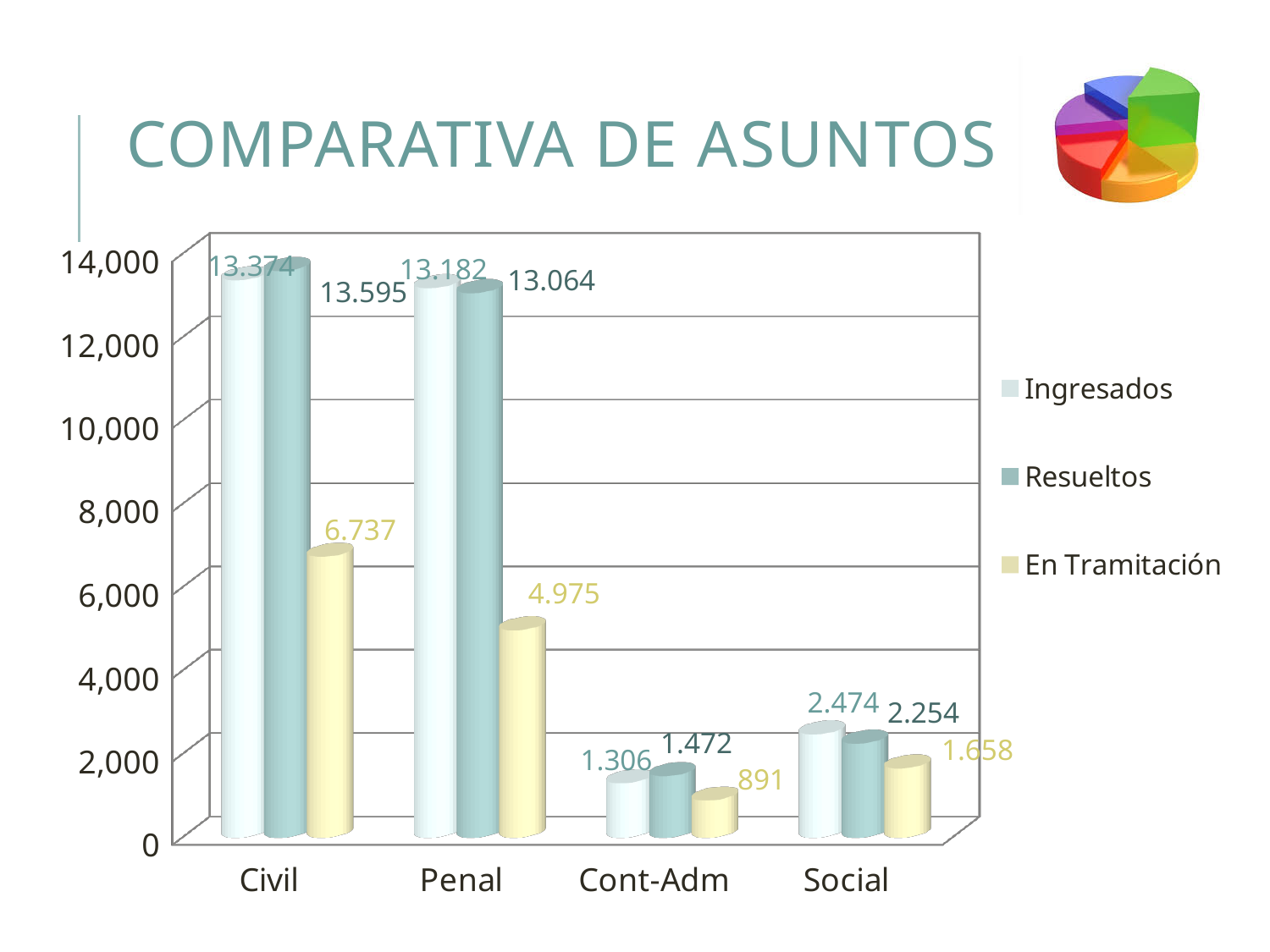
Which category has the lowest En Tramitación value? Cont-Adm Is the En Tramitación value for Penal greater or less than 6,000? less How many series does the legend list? 3 Which is larger for Cont-Adm, Ingresados or Resueltos? Resueltos Which category has the highest Resueltos value? Civil How many categories are shown on the x axis? 4 What kind of chart is shown on the slide? bar chart What is the difference between the Resueltos and Ingresados values for Civil? 221 What is the En Tramitación value for Cont-Adm? 891 What is the En Tramitación value for Social? 1.658 What is the Ingresados value for Civil? 13.374 What is the Resueltos value for Penal? 13.064